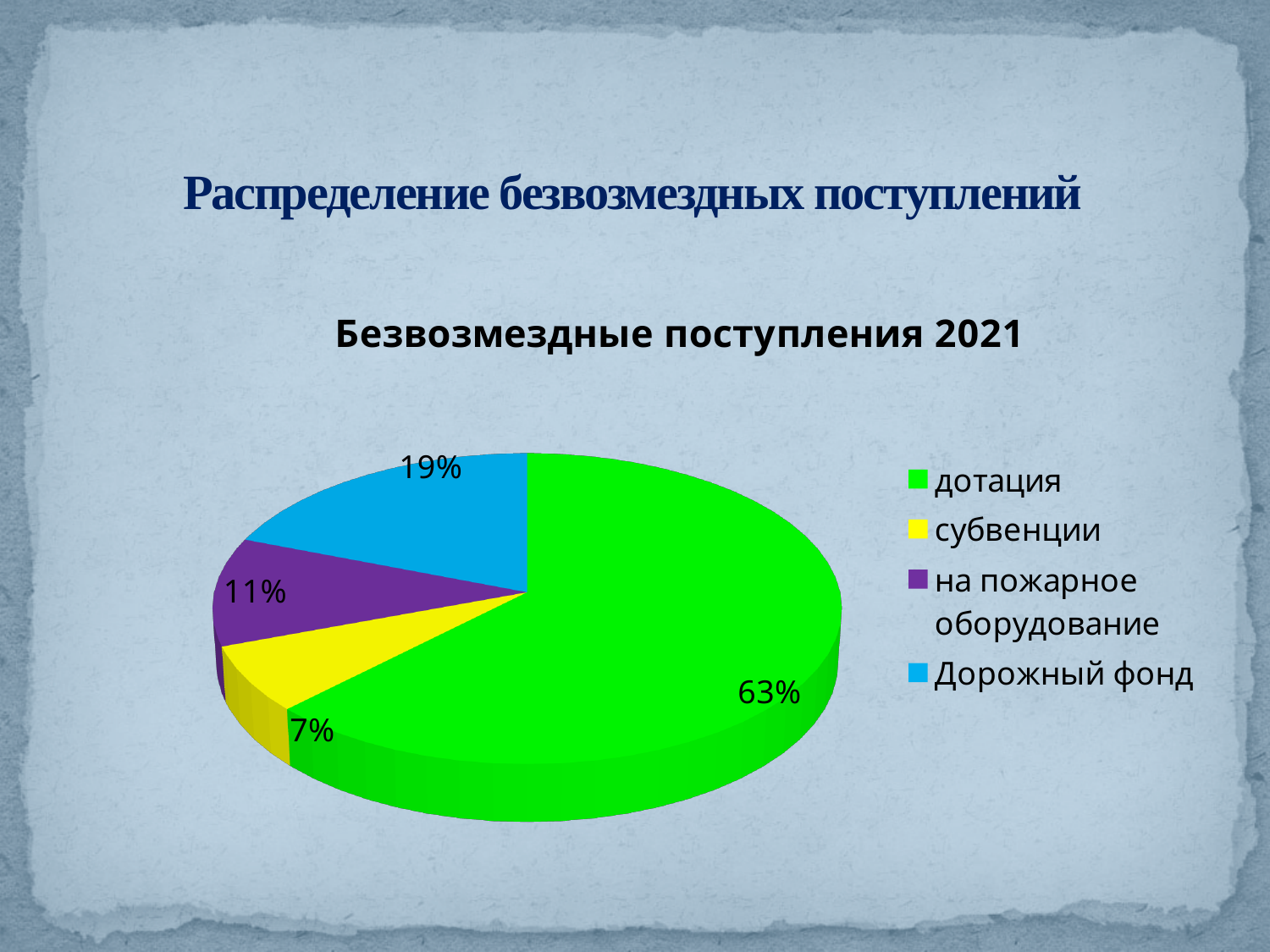
How many categories does the pie chart show? 4 What colour is the slice for субвенции? yellow What share of the pie does субвенции have? 7% What share of the pie does на пожарное оборудование have? 11% What share of the pie does Дорожный фонд have? 19% What is the difference in percentage points between дотация and Дорожный фонд? 44 Which is larger, the share for Дорожный фонд or the share for на пожарное оборудование? Дорожный фонд What kind of chart is shown on the slide? pie chart What share of the pie does дотация have? 63% Which category has the smallest slice of the pie? субвенции What is the title of the chart? Безвозмездные поступления 2021 Which category has the largest slice of the pie? дотация